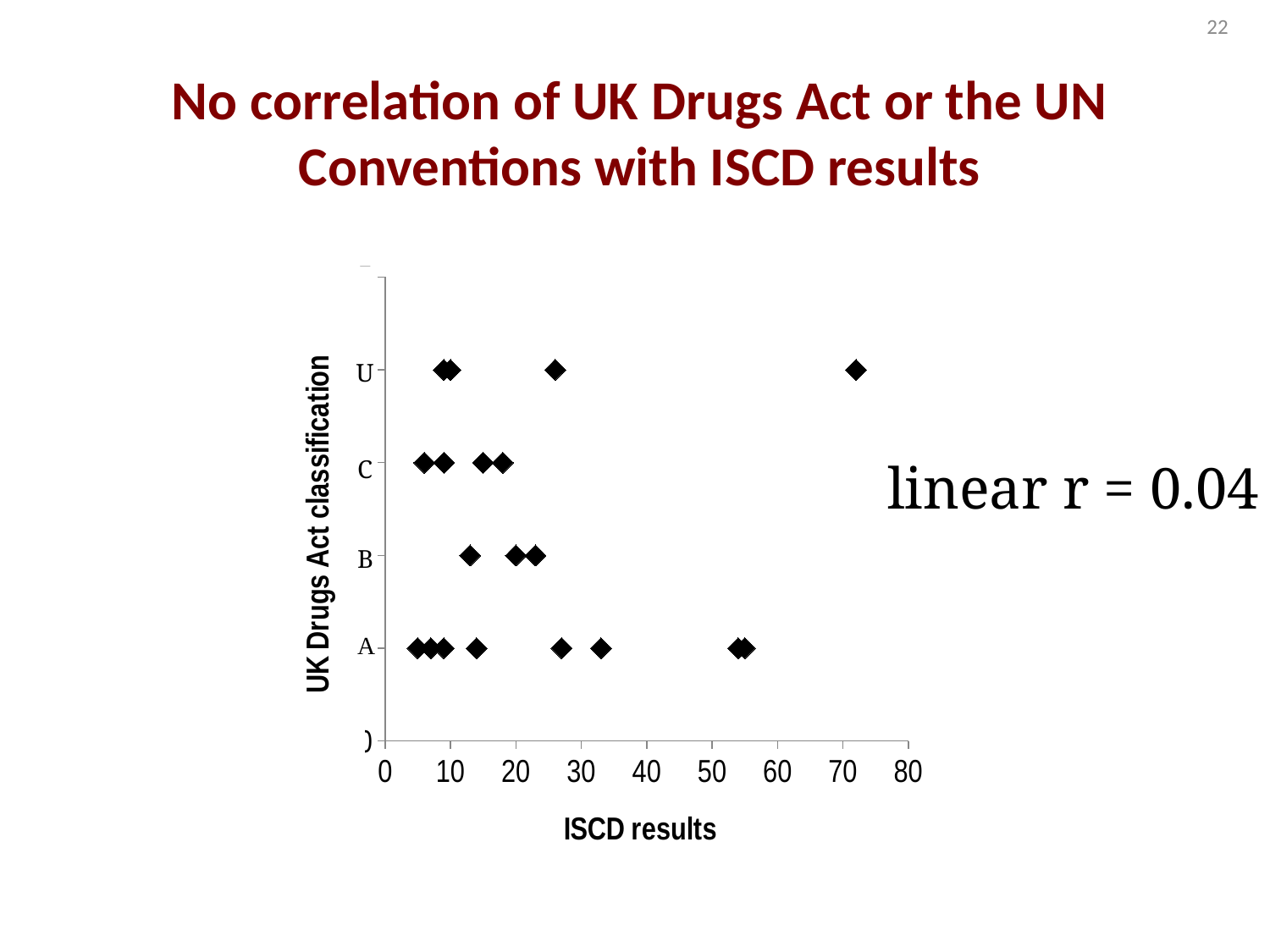
Is the ISCD result of the rightmost point in row B greater or less than 30? less What is the label of the x axis? ISCD results What linear correlation coefficient is stated on the slide? 0.04 Is the ISCD result of the rightmost point in row A greater or less than 50? greater How many points are plotted in row B? 3 Is the ISCD result of the rightmost point in row C greater or less than 30? less Which UK Drugs Act classification row contains the point with the highest ISCD result? U What is the label of the y axis? UK Drugs Act classification What is the highest value shown on the x axis? 80 Which row has a point with a larger ISCD result: row U or row B? U What kind of chart is shown on the slide? scatter plot